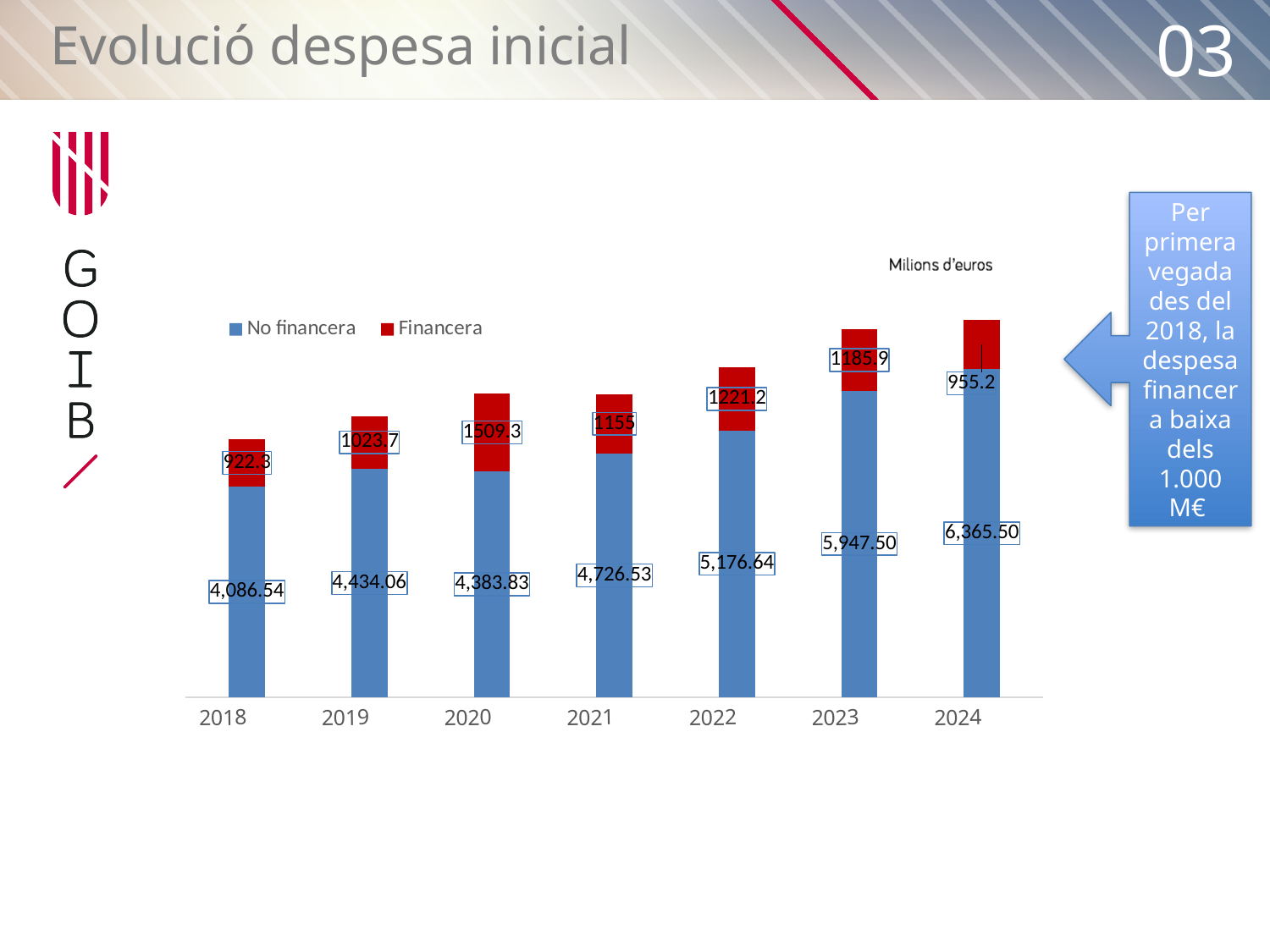
Which is larger, the Financera value for 2022 or for 2023? 2022 What is the total of the stacked bar for 2024? 7,320.70 What is the difference between the No financera values for 2024 and 2023? 418.00 How many years are shown on the x axis? 7 What kind of chart is shown on the slide? Stacked bar chart How many series does the legend list? 2 What is the No financera value for 2024? 6,365.50 What is the No financera value for 2018? 4,086.54 Which year has the highest Financera value? 2020 What unit is indicated above the chart? Milions d'euros Which year has the lowest No financera value? 2018 What is the Financera value for 2020? 1509.3